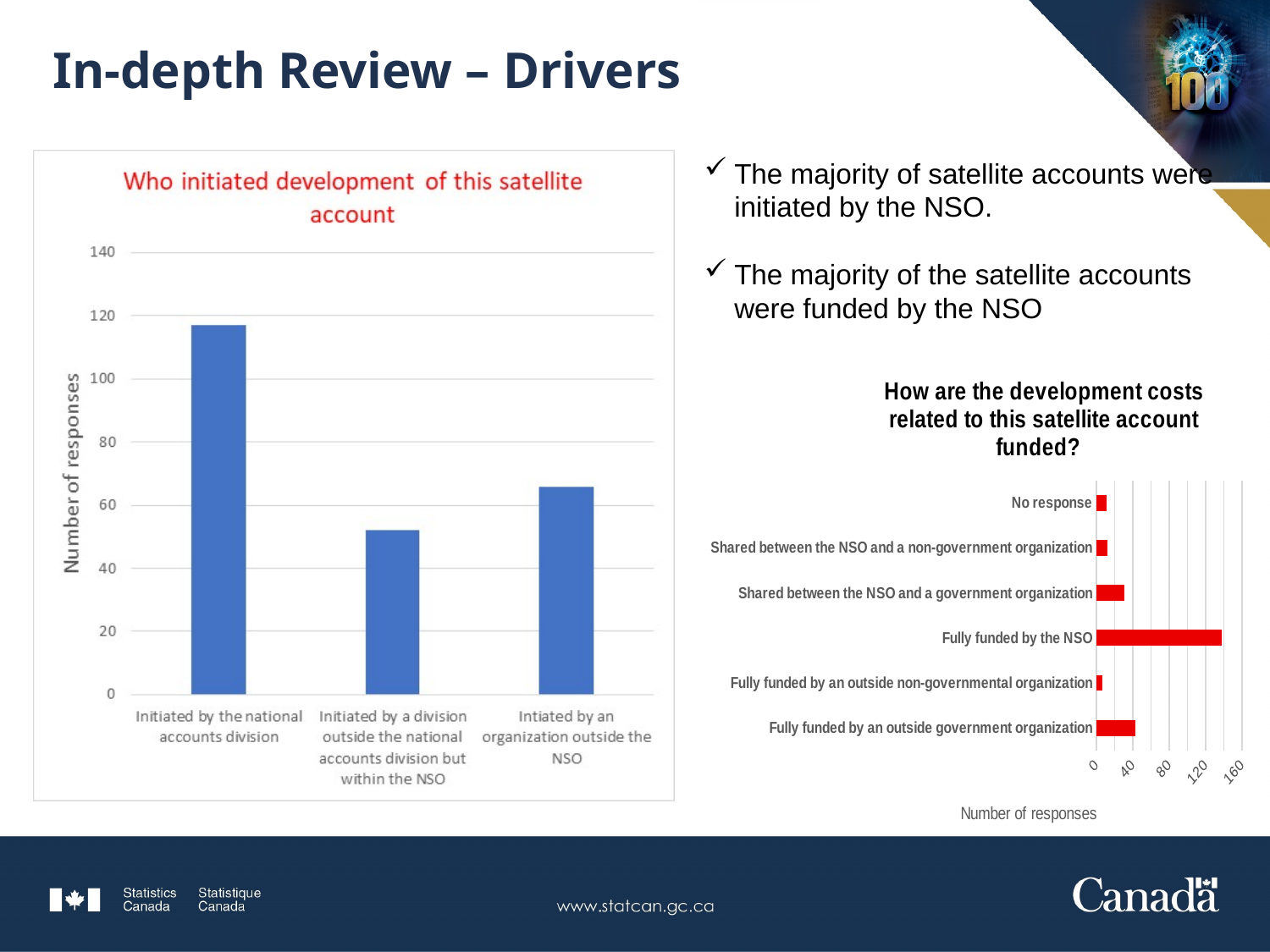
In the chart titled "How are the development costs related to this satellite account funded?", how many categories are plotted? 6 In the chart titled "How are the development costs related to this satellite account funded?", what colour are the bars? red In the chart titled "How are the development costs related to this satellite account funded?", which category has the highest number of responses? Fully funded by the NSO In the chart titled "Who initiated development of this satellite account", how many categories are plotted? 3 In the chart titled "How are the development costs related to this satellite account funded?", which is larger: "Fully funded by an outside government organization" or "Fully funded by an outside non-governmental organization"? Fully funded by an outside government organization In the chart titled "Who initiated development of this satellite account", what kind of chart is shown? bar chart In the chart titled "Who initiated development of this satellite account", which category has the lowest number of responses? Initiated by a division outside the national accounts division but within the NSO In the chart titled "Who initiated development of this satellite account", is the value for "Initiated by the national accounts division" greater or less than 100? greater In the chart titled "Who initiated development of this satellite account", which category has the highest number of responses? Initiated by the national accounts division In the chart titled "Who initiated development of this satellite account", is the value for "Initiated by an organization outside the NSO" greater or less than 80? less In the chart titled "How are the development costs related to this satellite account funded?", is the value for "Fully funded by the NSO" greater or less than 120? greater In the chart titled "Who initiated development of this satellite account", what is the label of the vertical axis? Number of responses